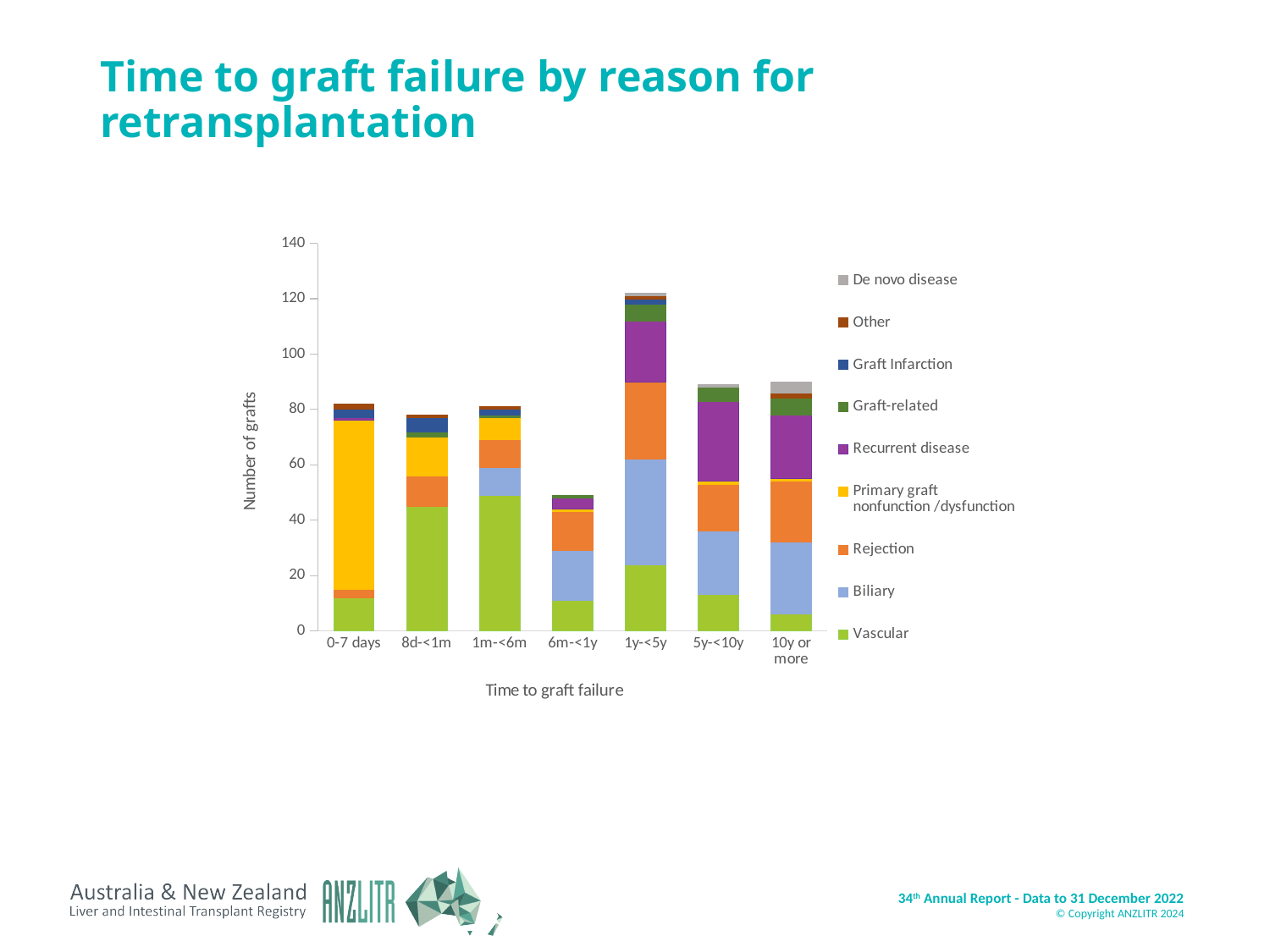
Is the total number of grafts for 0-7 days greater or less than 60? greater Is the total number of grafts for 1y-<5y greater or less than 100? greater In the 0-7 days bar, which segment is larger: Primary graft nonfunction/dysfunction or Vascular? Primary graft nonfunction/dysfunction What kind of chart is shown on the slide? Stacked bar chart Which has a larger total number of grafts, 1y-<5y or 5y-<10y? 1y-<5y Which time-to-graft-failure category has the highest total number of grafts? 1y-<5y How many time-to-graft-failure categories are shown on the x axis? 7 Which series is listed first (at the top) in the legend? De novo disease Is the total number of grafts for 6m-<1y greater or less than 60? less Which time-to-graft-failure category has the lowest total number of grafts? 6m-<1y How many series does the legend list? 9 What is the label of the vertical axis? Number of grafts